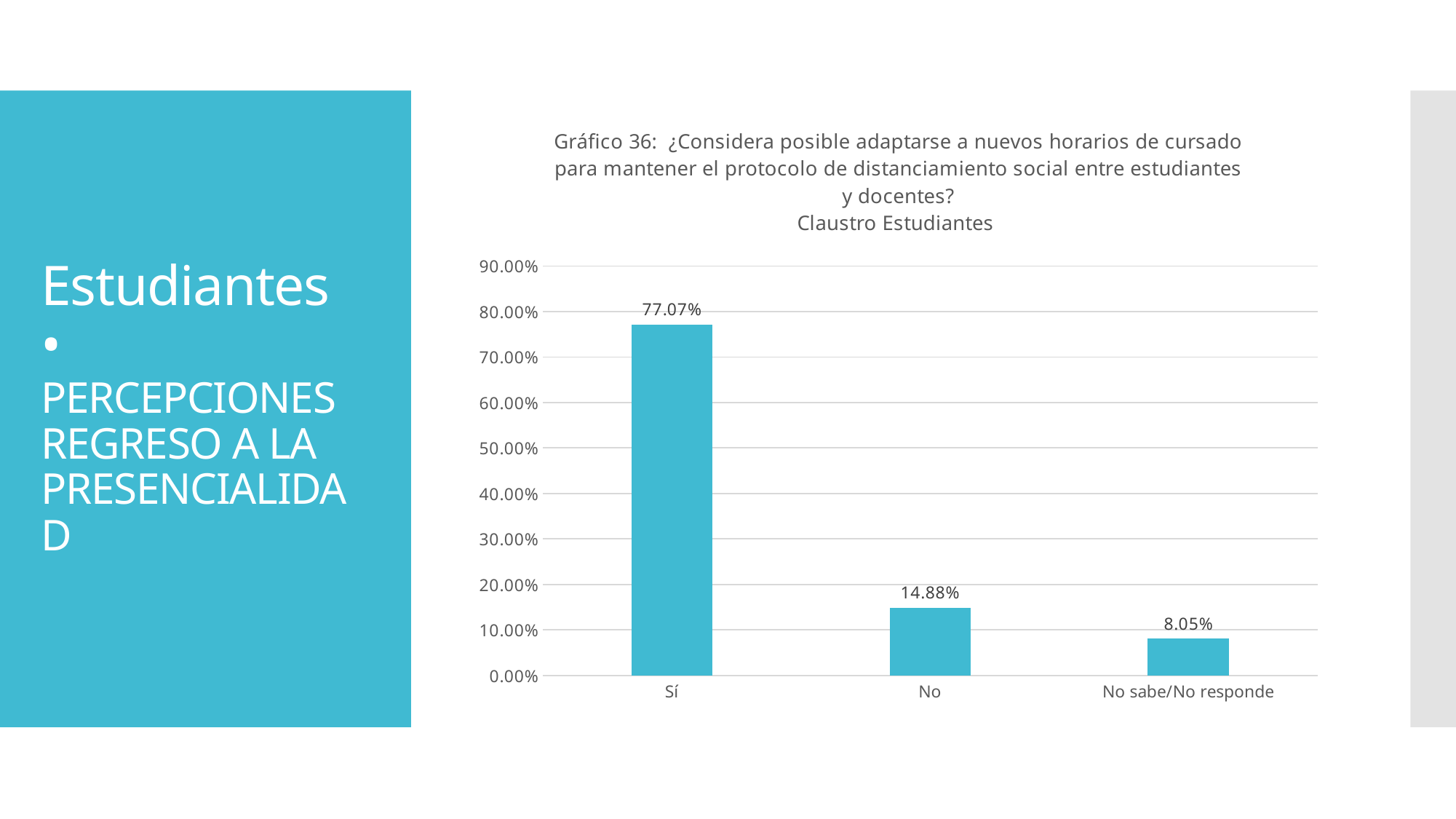
What is the difference between the values for "No" and "No sabe/No responde"? 6.83% Which category has the highest value? Sí Which is larger, the value for "No" or the value for "No sabe/No responde"? No Which claustro (group) does the chart title say the data is for? Claustro Estudiantes What is the difference between the values for "Sí" and "No"? 62.19% Which category has the lowest value? No sabe/No responde What is the value for "Sí"? 77.07% Is the value for "Sí" greater or less than 70.00%? greater What is the value for "No"? 14.88% What is the value for "No sabe/No responde"? 8.05% What kind of chart is shown on the slide? Bar chart How many categories are shown on the x axis? 3